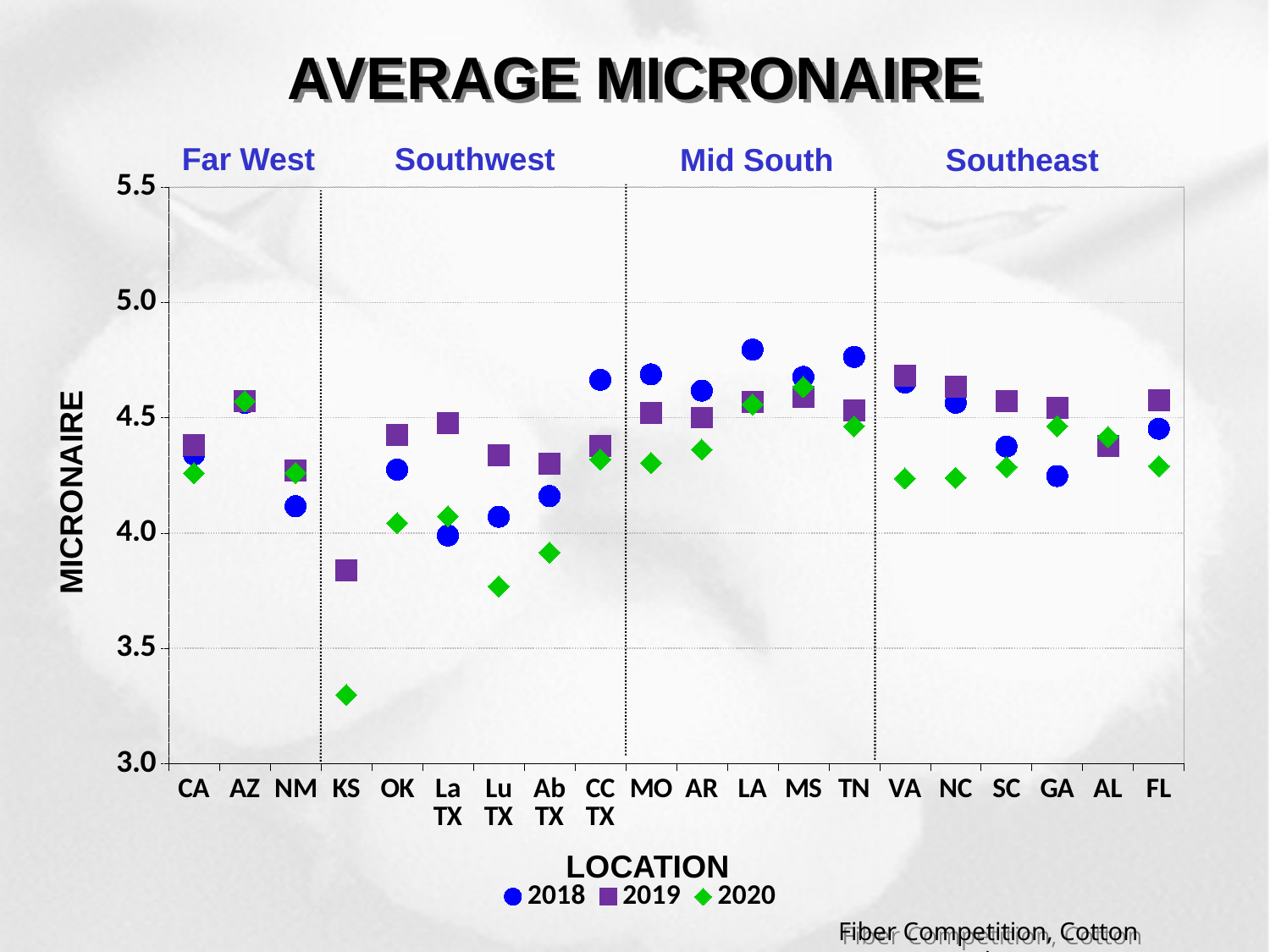
At OK, which is larger, the 2019 value or the 2020 value? 2019 Which location has the lowest 2019 value? KS Is the 2018 value for LA greater or less than 4.5? greater At GA, which is larger, the 2018 value or the 2020 value? 2020 Is the 2020 value for Lu TX greater or less than 4.0? less Which location has the lowest 2020 value? KS How many series does the legend list? 3 Is the 2019 value for KS greater or less than 4.0? less What kind of chart is shown on the slide? scatter chart What is the title of the y axis? MICRONAIRE How many locations are shown along the x axis? 20